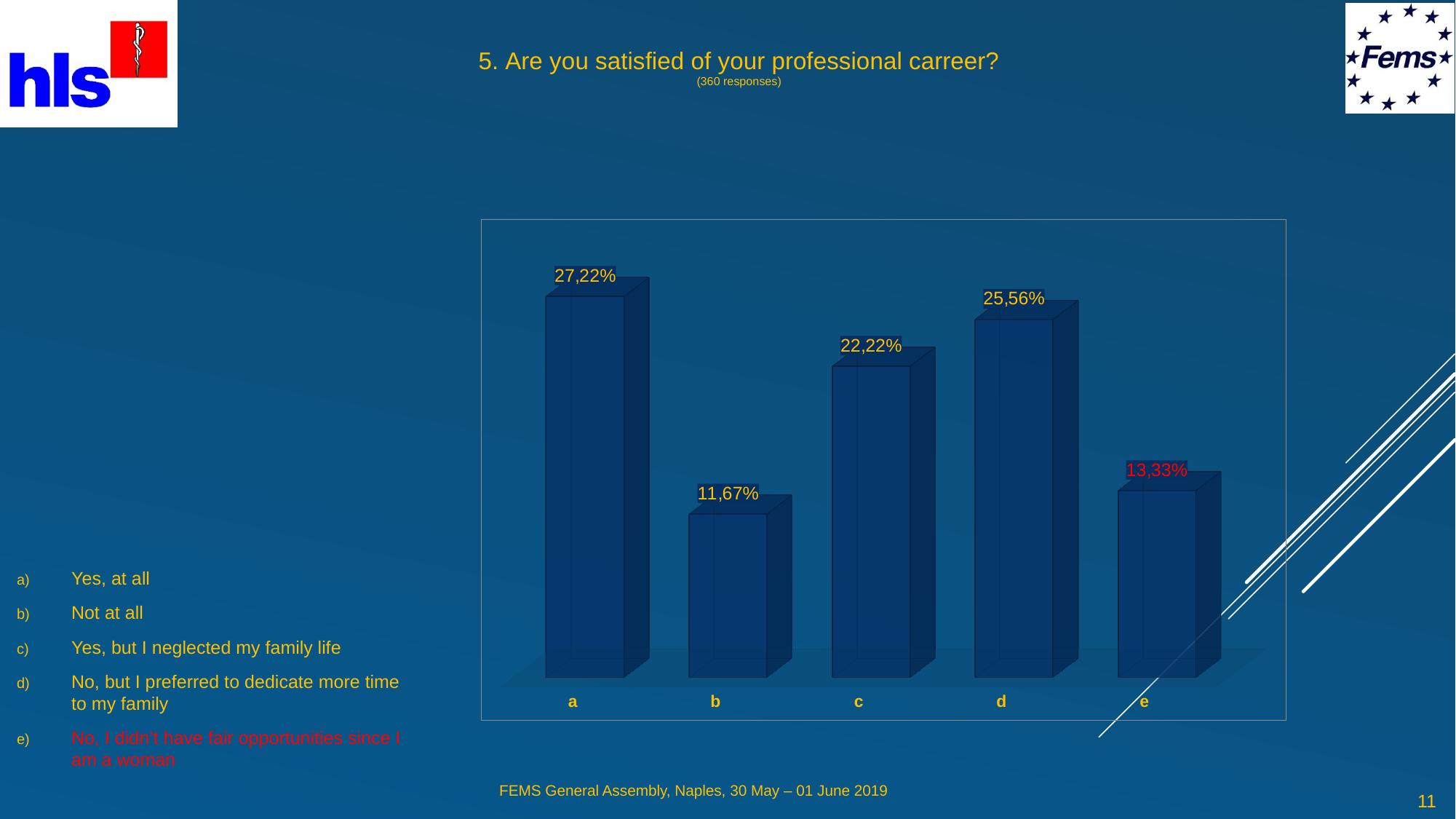
Which category has the lowest value? b What kind of chart is shown on the slide? bar chart What is the value for category c? 22,22% How many categories are shown in the chart? 5 What is the value for category a? 27,22% What is the value for category b? 11,67% What is the difference between the values for category a and category d? 1,66% What is the value for category d? 25,56% What is the difference between the values for category c and category b? 10,55% Which category has the highest value? a Which is larger, the value for category c or the value for category e? c What is the value for category e? 13,33%